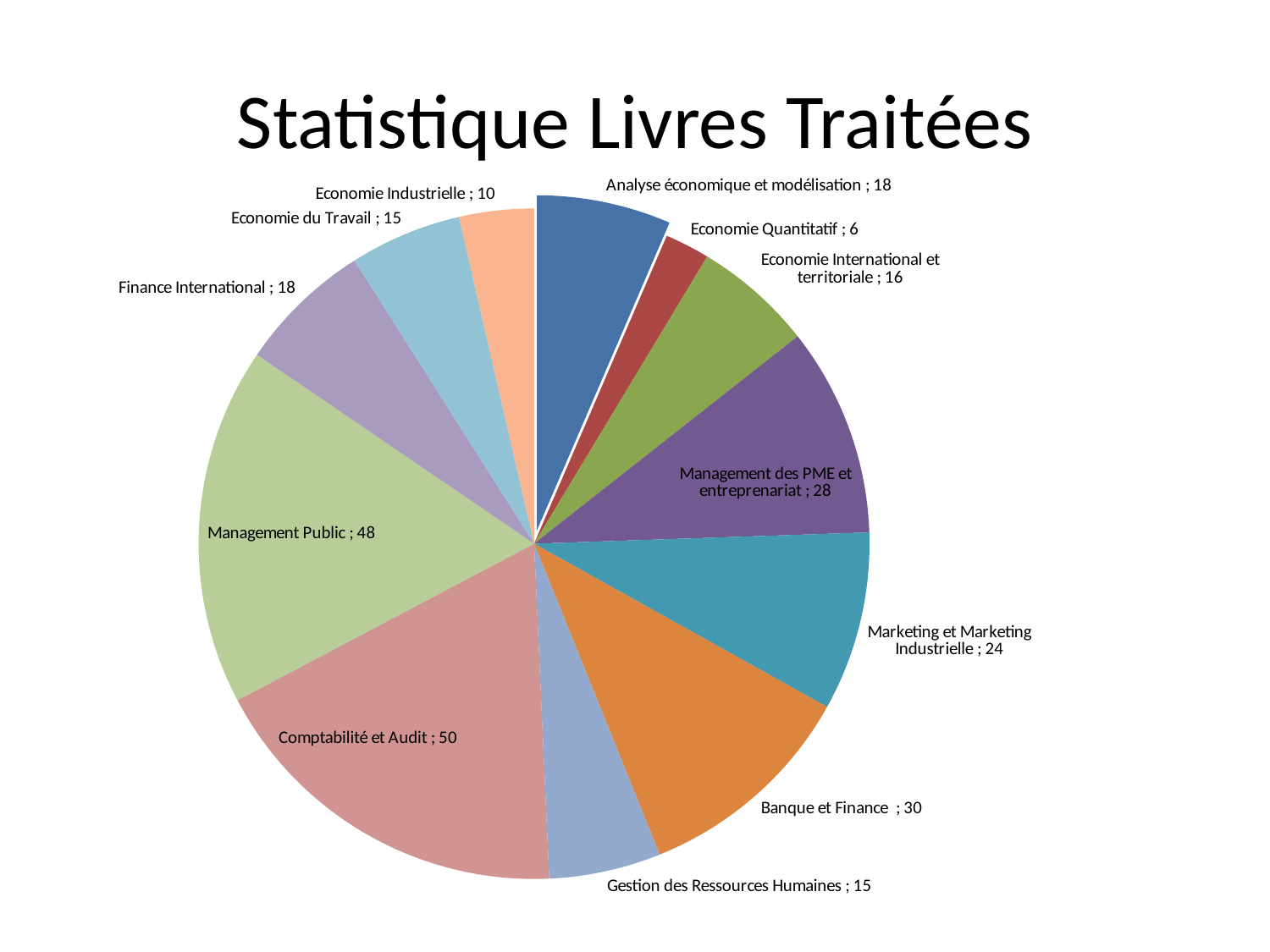
What is the value for Banque et Finance? 30 How many categories are shown in the pie chart? 12 What is the difference between Management Public and Marketing et Marketing Industrielle? 24 Which category has the lowest value? Economie Quantitatif What is the value for Management des PME et entreprenariat? 28 What is the difference between Banque et Finance and Gestion des Ressources Humaines? 15 What is the value for Economie Industrielle? 10 What is the value for Comptabilité et Audit? 50 Which category has the highest value? Comptabilité et Audit Which is larger, Finance International or Economie International et territoriale? Finance International What is the title of the chart? Statistique Livres Traitées What kind of chart is shown on the slide? Pie chart